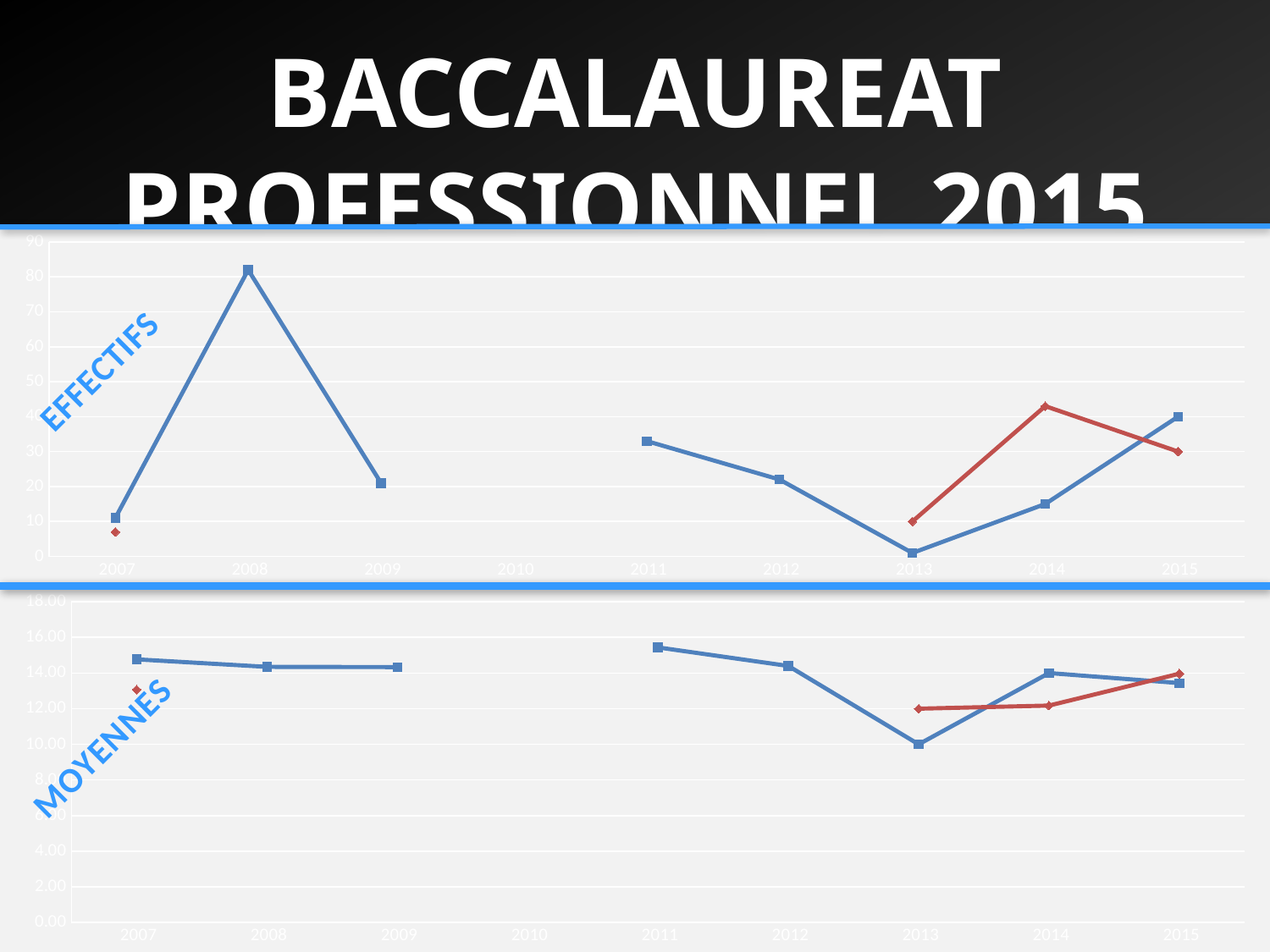
In the MOYENNES chart, is the blue line's value for 2013 greater or less than 12.00? less In the EFFECTIFS chart, which line has the larger value in 2015, the blue line or the red line? the blue line What kind of chart is the EFFECTIFS chart at the top of the slide? line chart What kind of chart is the MOYENNES chart at the bottom of the slide? line chart In the EFFECTIFS chart, is the blue line's value for 2008 greater or less than 80? greater In the MOYENNES chart, which line has the larger value in 2014, the blue line or the red line? the blue line In the EFFECTIFS chart, is the red line's value for 2014 greater or less than 40? greater In the EFFECTIFS chart, which year has the highest value on the blue line? 2008 In the EFFECTIFS chart, which year has the lowest value on the blue line? 2013 In the EFFECTIFS chart, does the blue line rise or fall from 2008 to 2009? fall How many years are labelled on the x axis of the MOYENNES chart? 9 In the MOYENNES chart, which year has the lowest value on the blue line? 2013